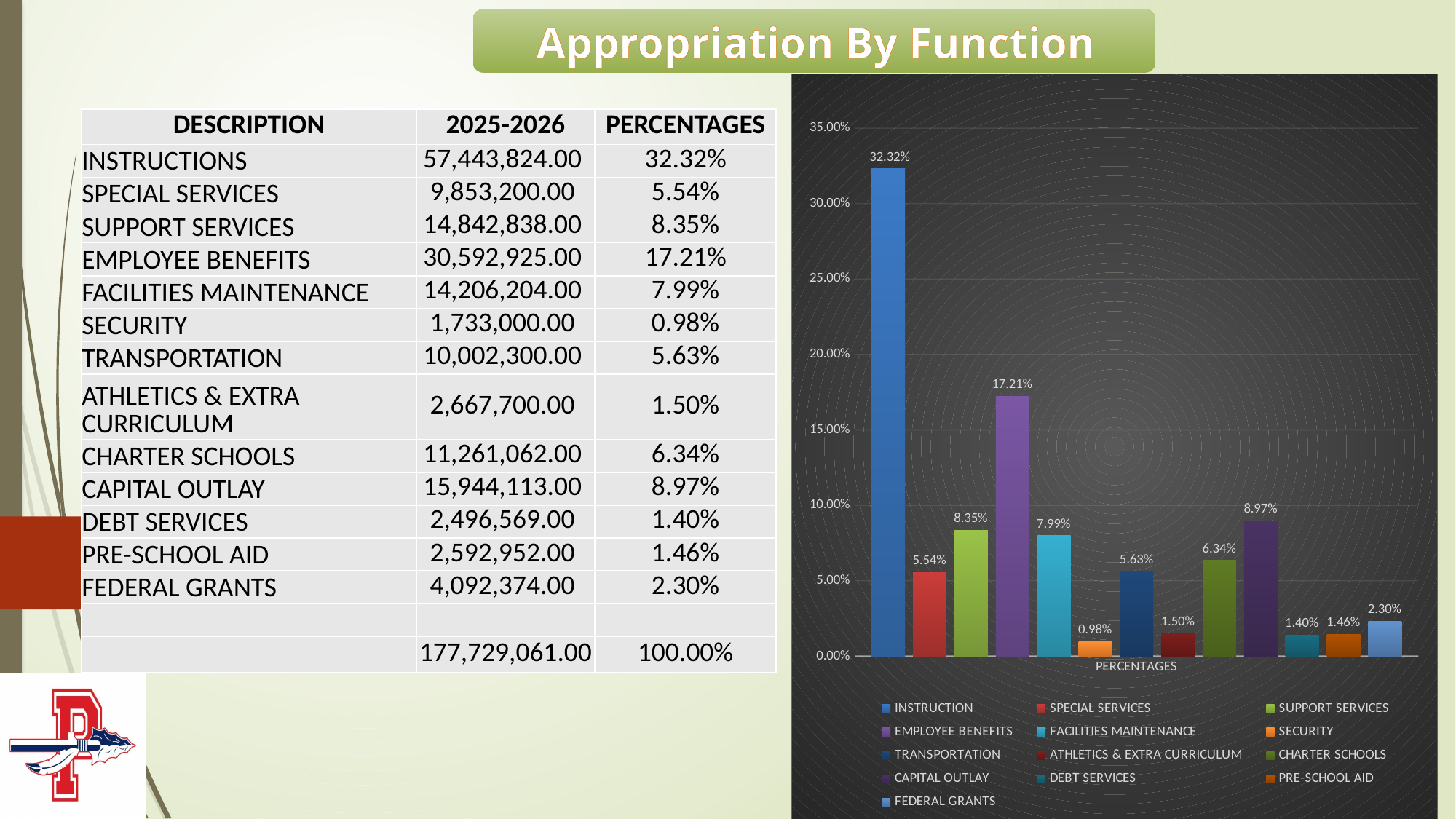
What kind of chart is shown on the slide? bar chart What is the label shown on the x axis of the chart? PERCENTAGES Which is larger in the chart, SUPPORT SERVICES or FACILITIES MAINTENANCE? SUPPORT SERVICES Which category has the lowest percentage in the chart? SECURITY What percentage does the chart show for CAPITAL OUTLAY? 8.97% What percentage does the chart show for EMPLOYEE BENEFITS? 17.21% Is the value for CHARTER SCHOOLS greater or less than 5.00%? greater Which category has the highest percentage in the chart? INSTRUCTION What is the difference between the percentages for INSTRUCTION and EMPLOYEE BENEFITS? 15.11% How many series does the chart legend list? 13 What is the highest value shown on the chart's y axis? 35.00% What percentage does the chart show for INSTRUCTION? 32.32%